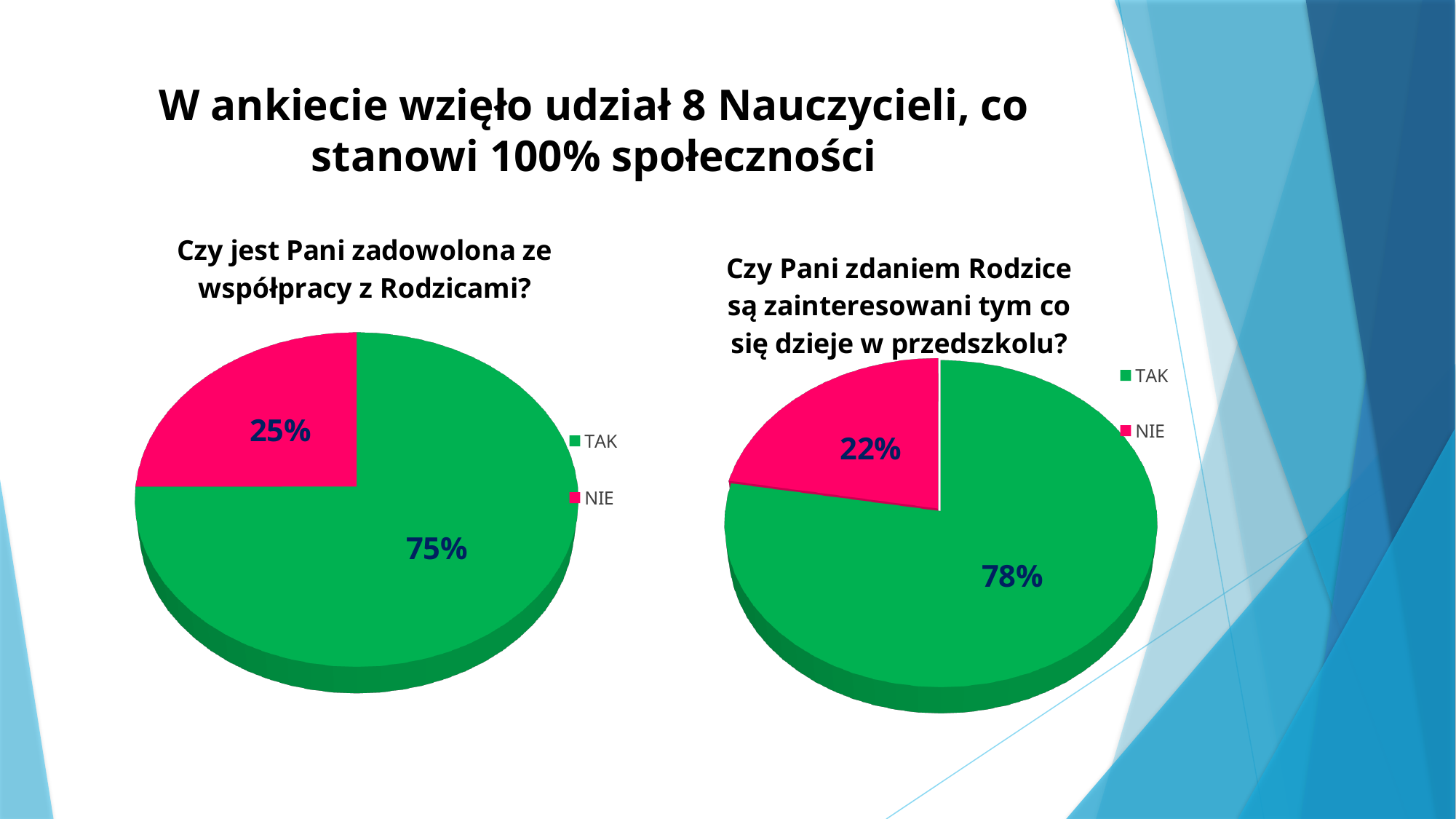
In the left pie chart, which colour represents NIE? Pink In the right pie chart ("Czy Pani zdaniem Rodzice są zainteresowani tym co się dzieje w przedszkolu?"), what share is labelled for TAK? 78% In the left pie chart ("Czy jest Pani zadowolona ze współpracy z Rodzicami?"), what share is labelled for TAK? 75% What kind of chart is used on the left of the slide? Pie chart In the right pie chart ("Czy Pani zdaniem Rodzice są zainteresowani tym co się dzieje w przedszkolu?"), what share is labelled for NIE? 22% In the left pie chart, which slice is the largest? TAK In the right pie chart, which slice is the smallest? NIE In the left pie chart ("Czy jest Pani zadowolona ze współpracy z Rodzicami?"), what share is labelled for NIE? 25% In the left pie chart, what is the difference between the TAK and NIE shares? 50% How many slices does the right pie chart have? 2 Which is larger: the NIE share in the left pie chart or the NIE share in the right pie chart? The left pie chart (25%) In the right pie chart, what is the difference between the TAK and NIE shares? 56%